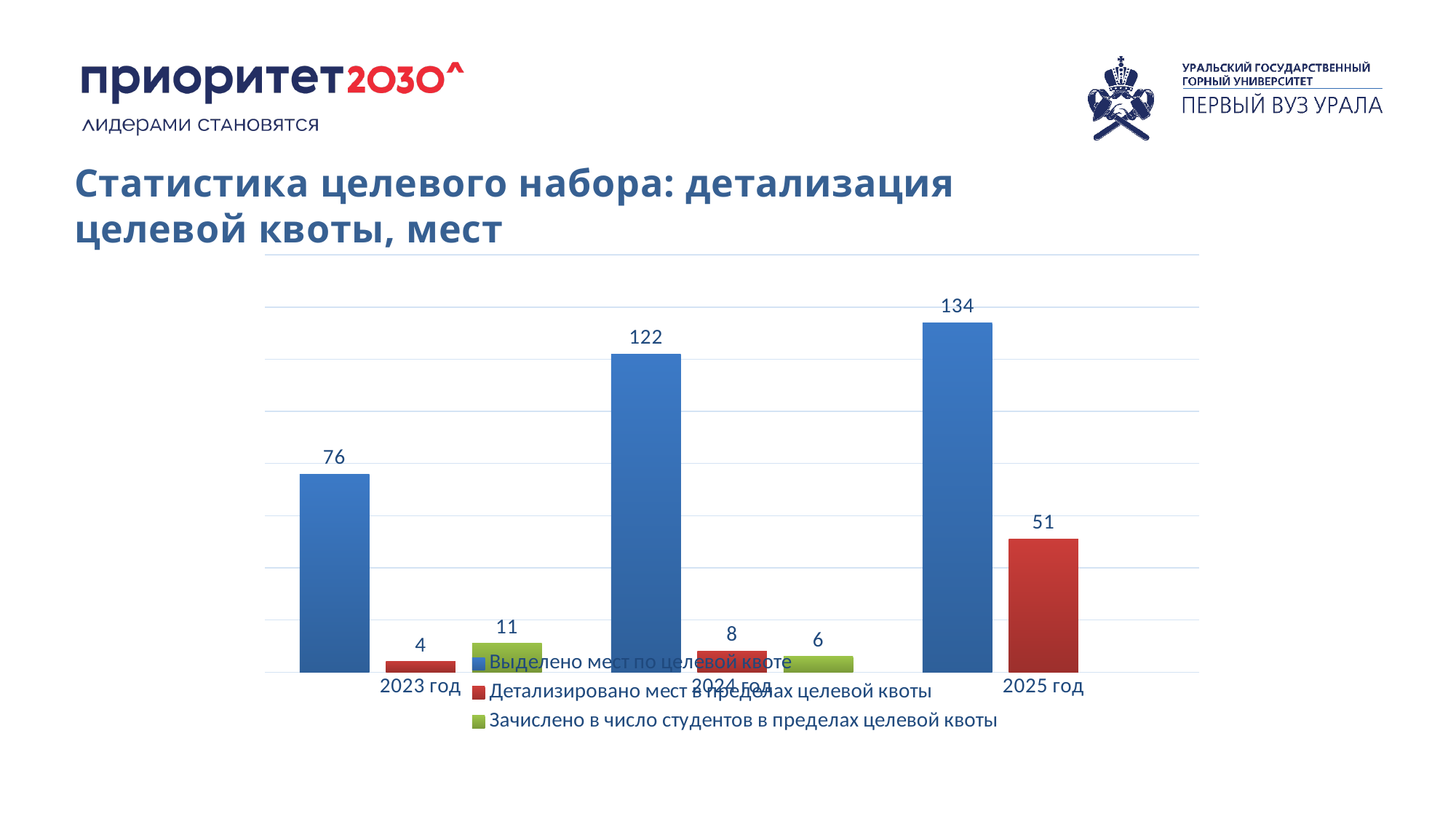
How many years are shown on the x axis of the chart? 3 Does 'Выделено мест по целевой квоте' rise or fall from 2023 год to 2025 год? rise In which year is 'Детализировано мест в пределах целевой квоты' the lowest? 2023 год What is the value of 'Детализировано мест в пределах целевой квоты' for 2025 год? 51 What is the value of 'Зачислено в число студентов в пределах целевой квоты' for 2023 год? 11 What is the value of 'Выделено мест по целевой квоте' for 2025 год? 134 What is the value of 'Выделено мест по целевой квоте' for 2023 год? 76 What is the difference between 'Выделено мест по целевой квоте' in 2025 год and 2024 год? 12 How many series does the chart legend list? 3 What is the value of 'Детализировано мест в пределах целевой квоты' for 2024 год? 8 In which year is 'Выделено мест по целевой квоте' the highest? 2025 год Which is larger for 2024 год: 'Детализировано мест в пределах целевой квоты' or 'Зачислено в число студентов в пределах целевой квоты'? Детализировано мест в пределах целевой квоты